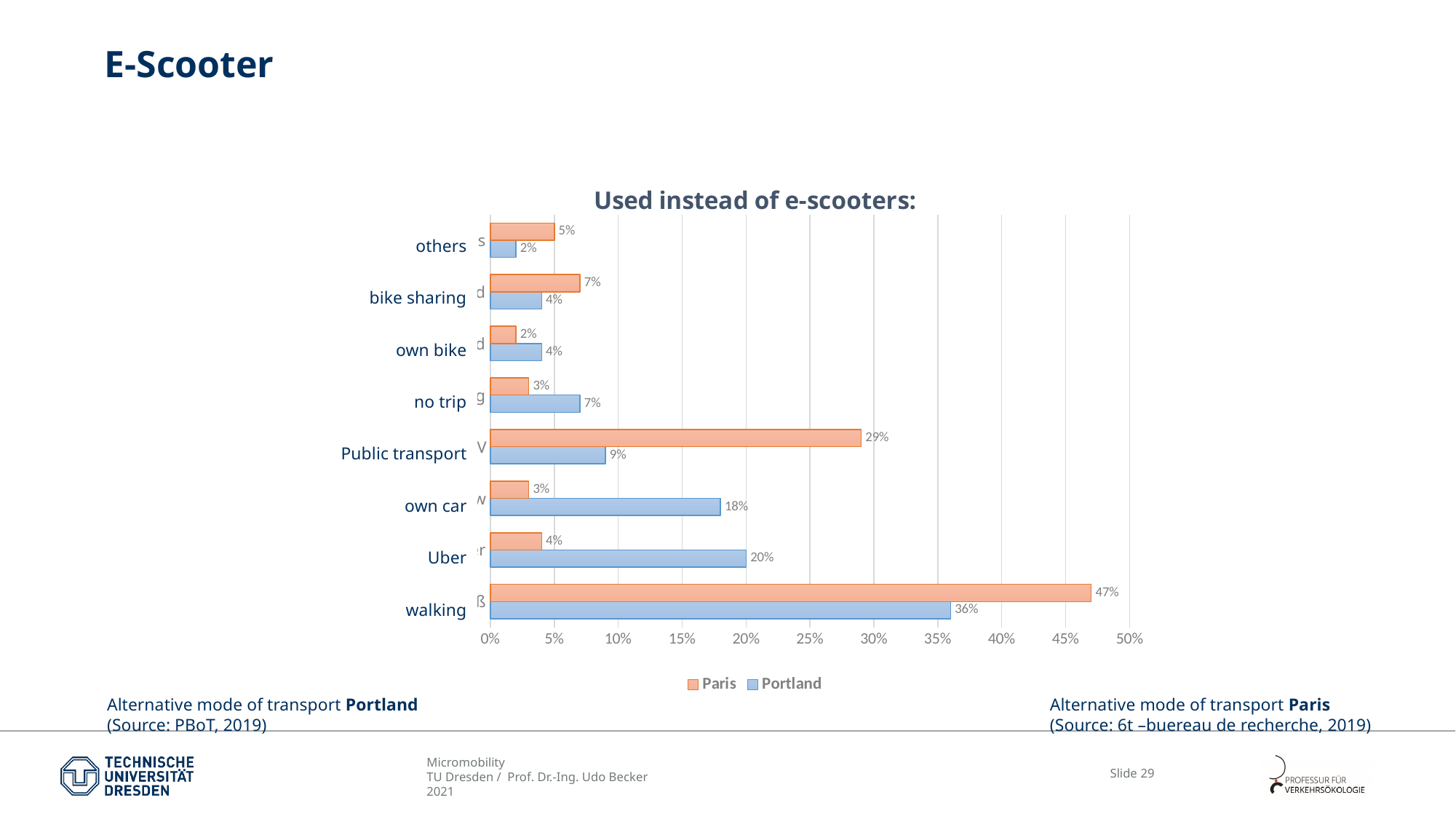
Which category has the highest Paris value? walking Which is larger for no trip, the Paris value or the Portland value? Portland Which category has the lowest Portland value? others How many categories are shown on the chart? 8 What is the difference between the Portland and Paris values for Uber? 16% What kind of chart is shown on the slide? bar chart How many series does the legend list? 2 What is the Paris value for Public transport? 29% What is the difference between the Paris and Portland values for walking? 11% What is the Portland value for Uber? 20% Is the Paris value for walking greater or less than 45%? greater What is the Portland value for own car? 18%